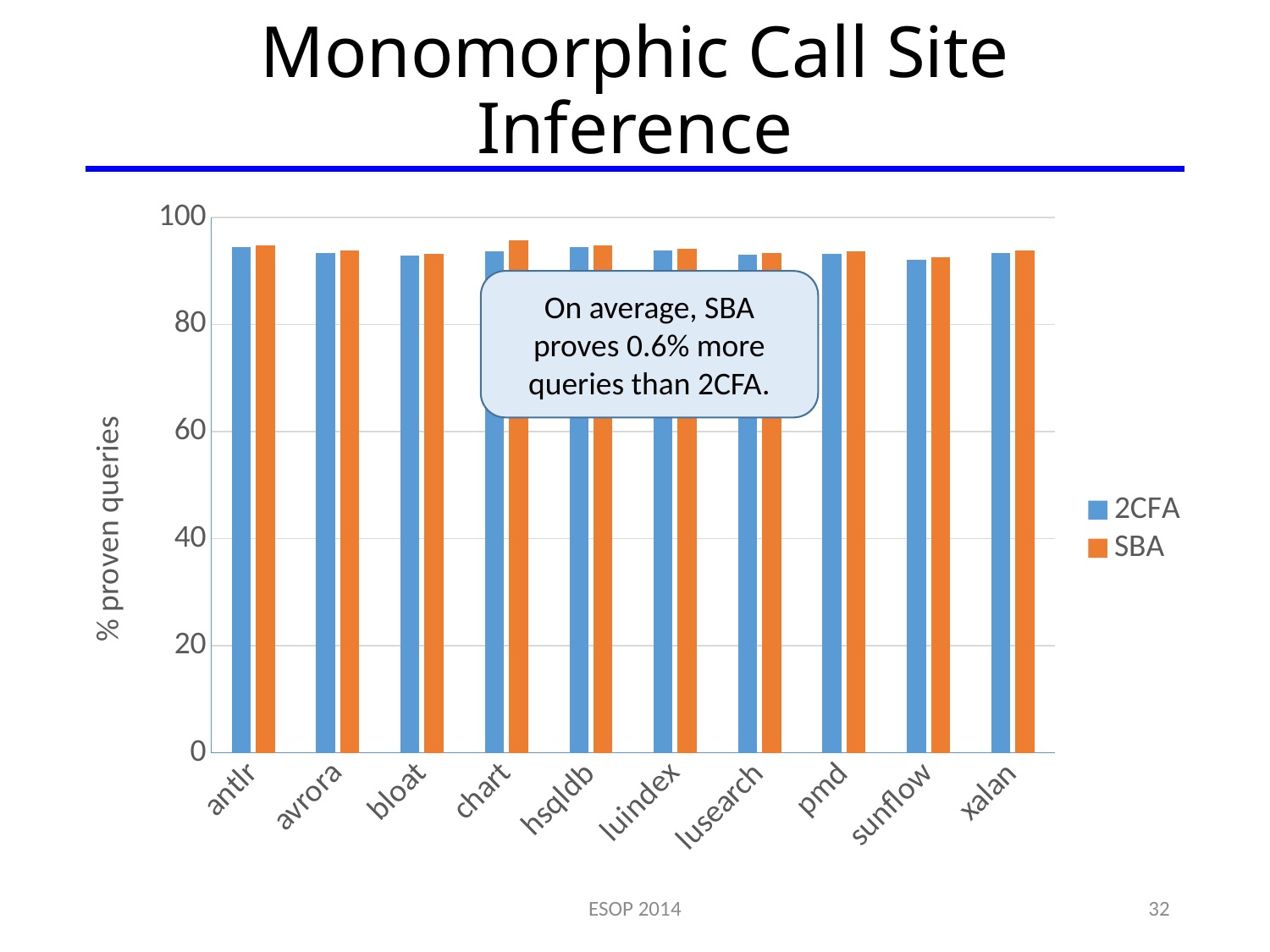
Is the 2CFA value for antlr greater or less than 80? greater Is the 2CFA value for lusearch greater or less than 40? greater Is the SBA value for bloat greater or less than 80? greater How many benchmark categories are shown on the x axis? 10 For the chart benchmark, which series has the larger value, 2CFA or SBA? SBA What is the label of the y axis? % proven queries What are the two series named in the legend? 2CFA and SBA What kind of chart is shown on the slide? bar chart How many series does the legend list? 2